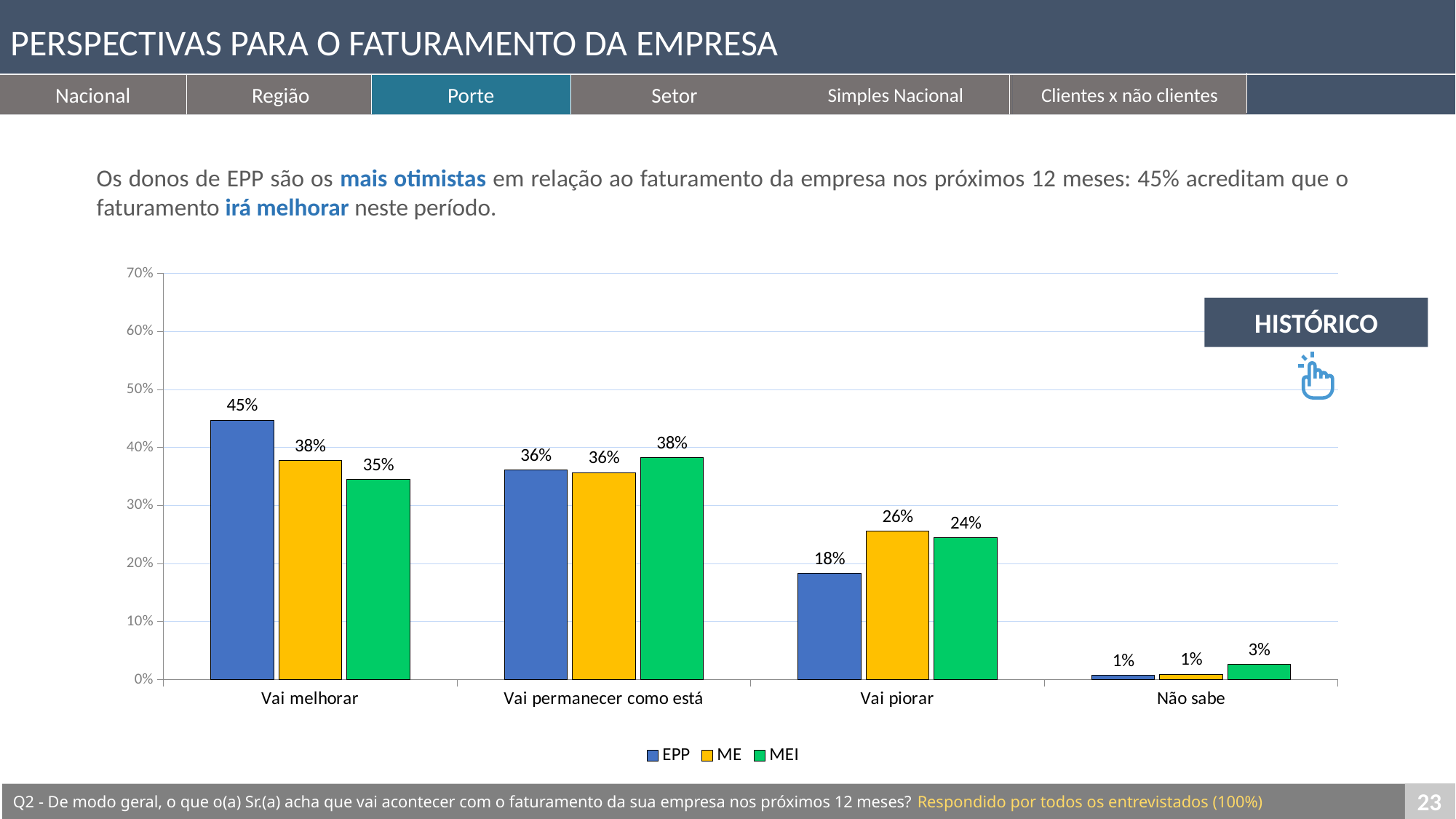
Is the value for EPP in 'Vai melhorar' greater or less than 40%? greater How many categories are shown on the x axis? 4 Which series is shown in green in the legend? MEI Which is larger: the MEI value for 'Vai melhorar' or the MEI value for 'Vai permanecer como está'? Vai permanecer como está How many series does the legend list? 3 What is the difference between the ME and EPP values in the 'Vai piorar' category? 8% Which series has the highest value in the 'Vai melhorar' category? EPP What kind of chart is shown on the slide? Bar chart What is the value for MEI in the 'Vai piorar' category? 24% What is the value for EPP in the 'Vai melhorar' category? 45% What is the value for ME in the 'Vai permanecer como está' category? 36% Which series has the lowest value in the 'Vai piorar' category? EPP